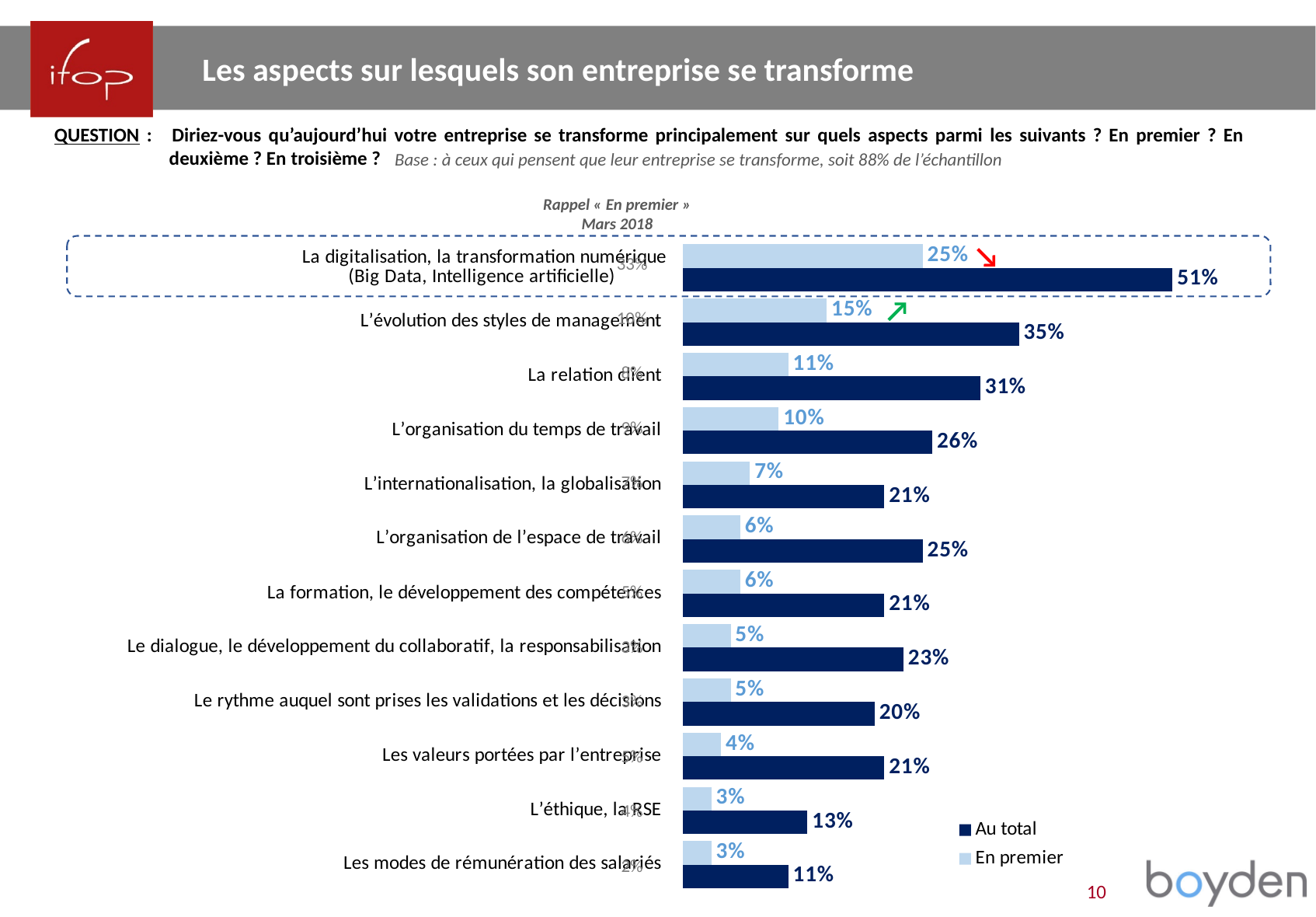
How many series does the legend list? 2 What is the difference between the "Au total" and "En premier" values for "L'organisation du temps de travail"? 16 percentage points What is the "En premier" value for "L'évolution des styles de management"? 15% What type of chart is shown on the slide? Bar chart Which category has the highest "Au total" value? La digitalisation, la transformation numérique (Big Data, Intelligence artificielle) What is the "Au total" value for "La relation client"? 31% Which series is shown in dark blue according to the legend? Au total Which category has the lowest "Au total" value? Les modes de rémunération des salariés Which has a larger "Au total" value: "L'organisation de l'espace de travail" or "Le dialogue, le développement du collaboratif, la responsabilisation"? L'organisation de l'espace de travail What is the "Au total" value for "La digitalisation, la transformation numérique (Big Data, Intelligence artificielle)"? 51% What is the "En premier" value for "Les valeurs portées par l'entreprise"? 4% How many categories are shown in the chart? 12